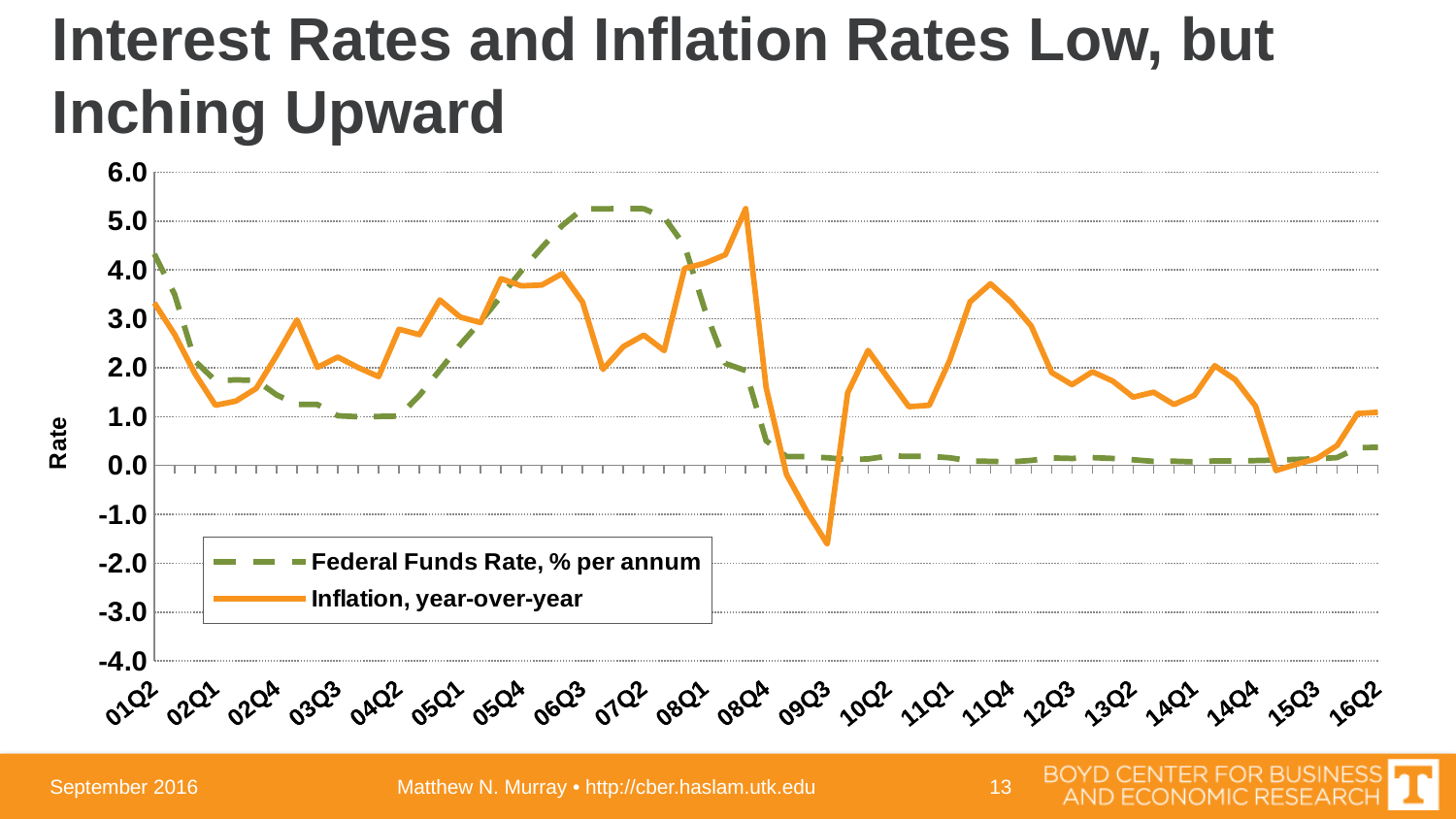
Is the Federal Funds Rate at 07Q2 greater or less than 5.0? greater Which series is drawn with a dashed line? Federal Funds Rate, % per annum Does the Federal Funds Rate rise or fall between 07Q2 and 09Q3? Fall How many quarter labels are shown along the x axis? 21 Is the Federal Funds Rate at 16Q2 greater or less than 1.0? less What is the title of the chart on the slide? Interest Rates and Inflation Rates Low, but Inching Upward At 07Q2, which series has the higher value, Federal Funds Rate or Inflation, year-over-year? Federal Funds Rate, % per annum Is the Inflation, year-over-year value at 11Q4 greater or less than 3.0? greater How many series does the legend list? 2 What kind of chart is shown on the slide? Line chart